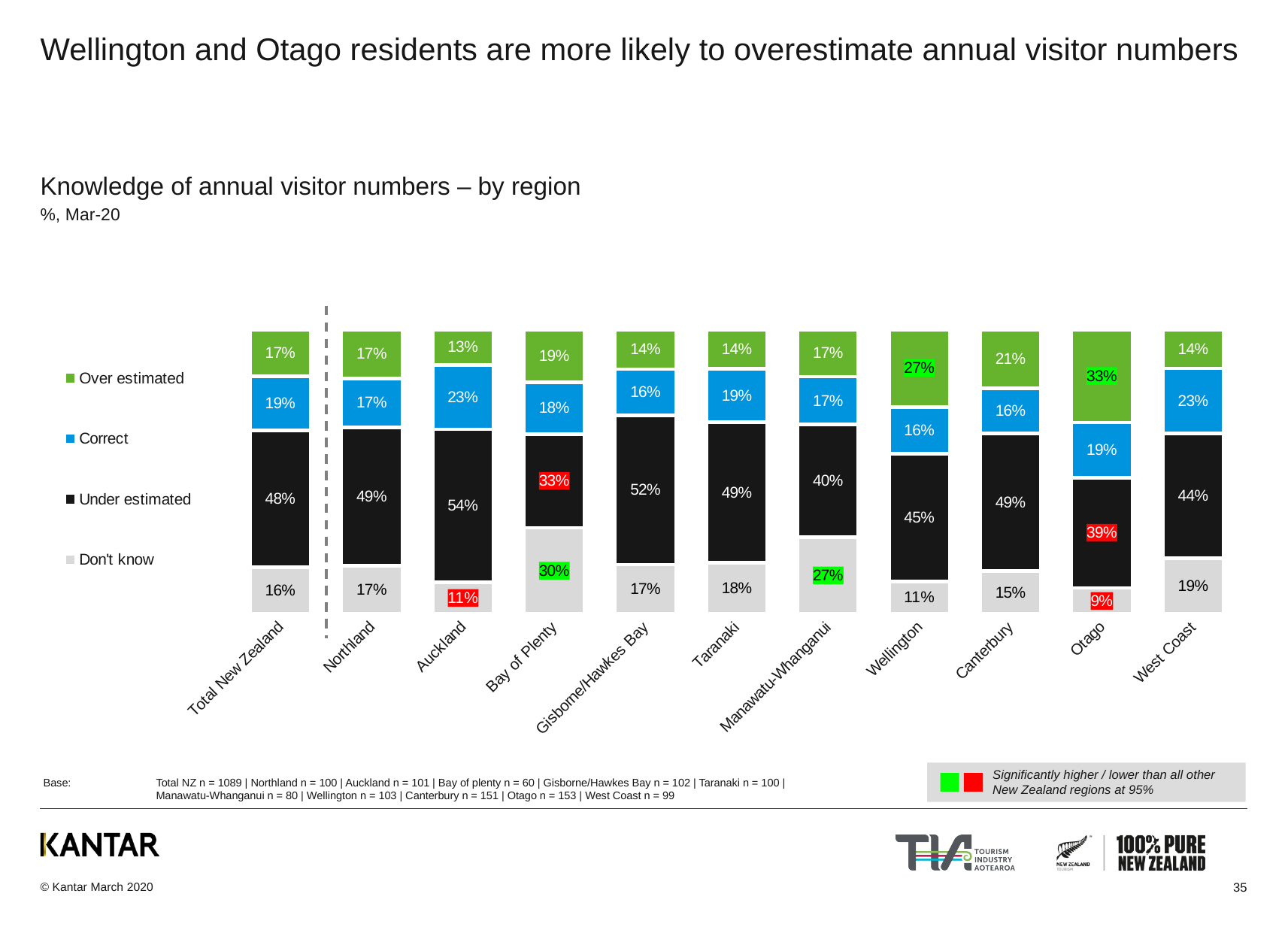
How many bars (regions including Total New Zealand) are shown in the chart? 11 What is the total of the stacked bar for Otago? 100% What kind of chart is shown on the slide? Stacked bar chart What is the 'Correct' value for West Coast? 23% What is the 'Don't know' value for Bay of Plenty? 30% What is the 'Under estimated' value for Auckland? 54% What is the difference between the 'Under estimated' values for Auckland and Otago? 15% Which has a larger 'Over estimated' share, Canterbury or Taranaki? Canterbury Which region has the highest 'Over estimated' percentage? Otago Which region has the lowest 'Don't know' percentage? Otago How many series does the legend list? 4 What percentage of Wellington residents over estimated annual visitor numbers? 27%